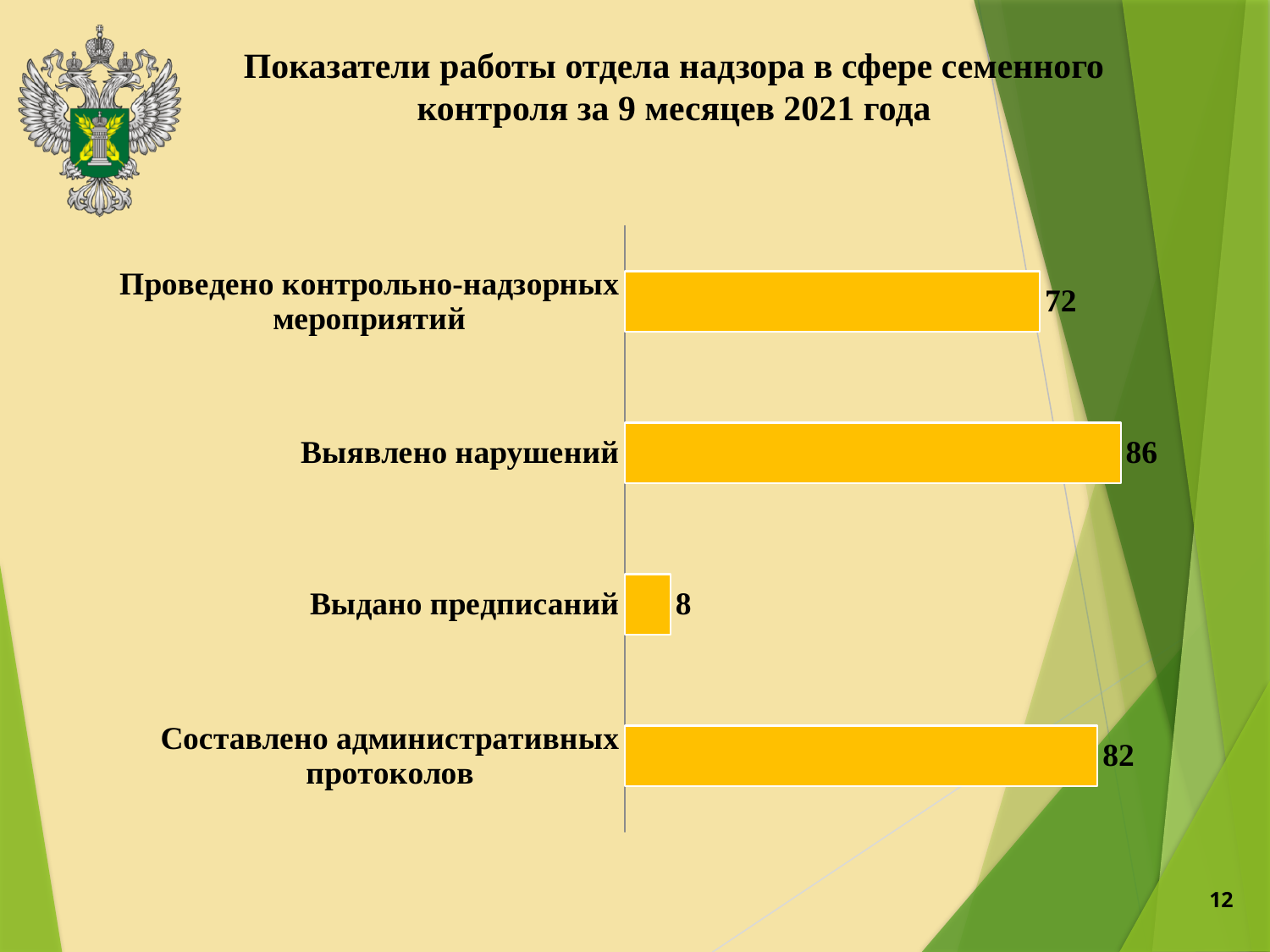
Which category has the highest value? Выявлено нарушений What is the title of the slide? Показатели работы отдела надзора в сфере семенного контроля за 9 месяцев 2021 года Which category has the lowest value? Выдано предписаний What kind of chart is shown on the slide? Bar chart What value is shown for «Проведено контрольно-надзорных мероприятий»? 72 How many categories are shown in the chart? 4 What is the difference between «Выявлено нарушений» and «Проведено контрольно-надзорных мероприятий»? 14 What is the difference between «Составлено административных протоколов» and «Выдано предписаний»? 74 What value is shown for «Составлено административных протоколов»? 82 Which is larger: «Составлено административных протоколов» or «Проведено контрольно-надзорных мероприятий»? Составлено административных протоколов What value is shown for «Выдано предписаний»? 8 What value is shown for «Выявлено нарушений»? 86